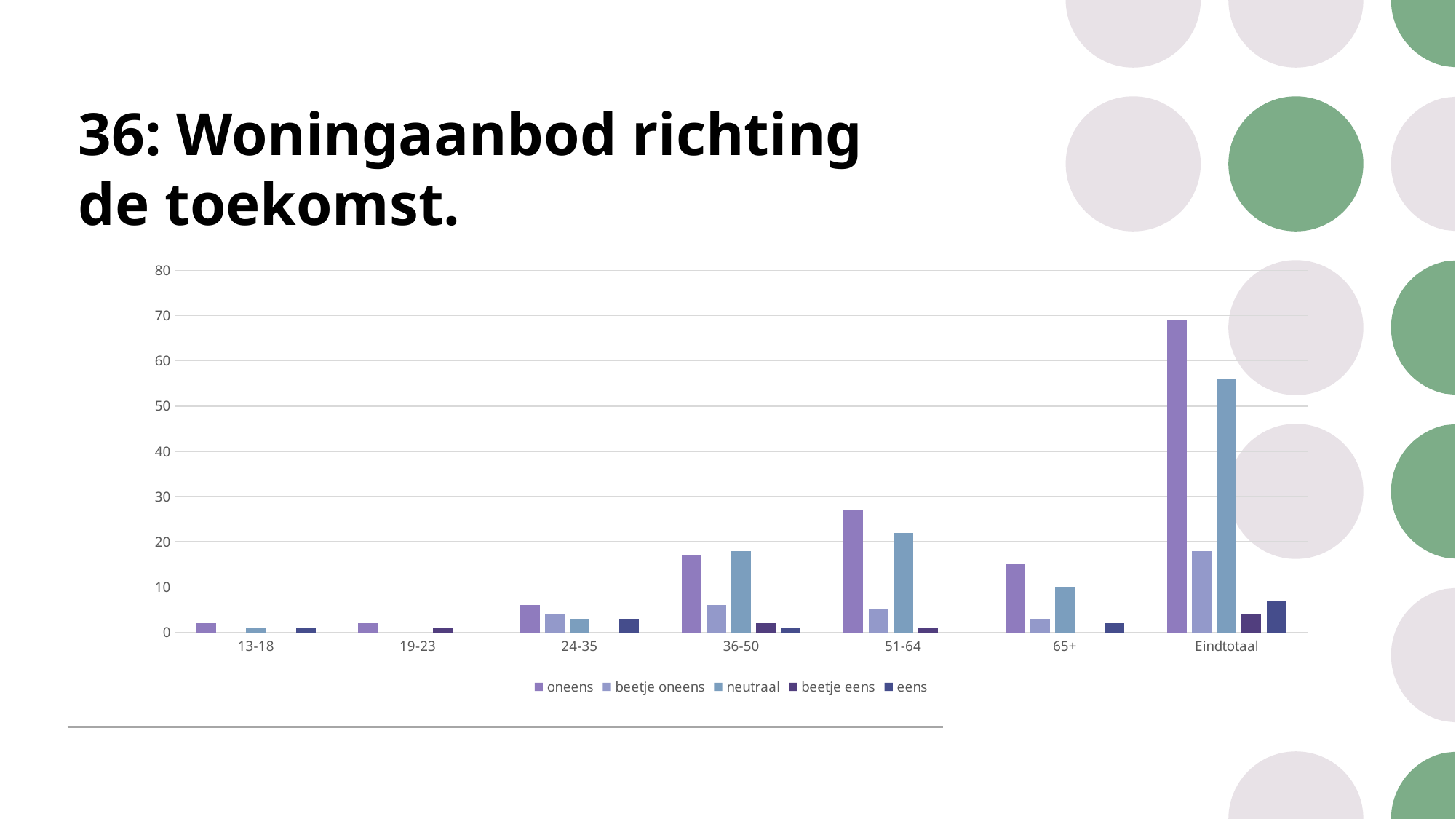
How many series does the chart's legend list? 5 How many categories are shown along the x axis of the chart? 7 For 51-64, which is larger: the 'oneens' bar or the 'neutraal' bar? oneens Is the 'eens' value for Eindtotaal greater or less than 10? less Among the age groups 13-18 through 65+, which has the tallest 'neutraal' bar? 51-64 Which category has the tallest 'oneens' bar? Eindtotaal Is the 'oneens' value for 51-64 greater or less than 20? greater What kind of chart is shown on the slide? bar chart For Eindtotaal, which is larger: the 'oneens' bar or the 'neutraal' bar? oneens Is the 'oneens' value for Eindtotaal greater or less than 60? greater What is the last entry listed in the chart's legend? eens